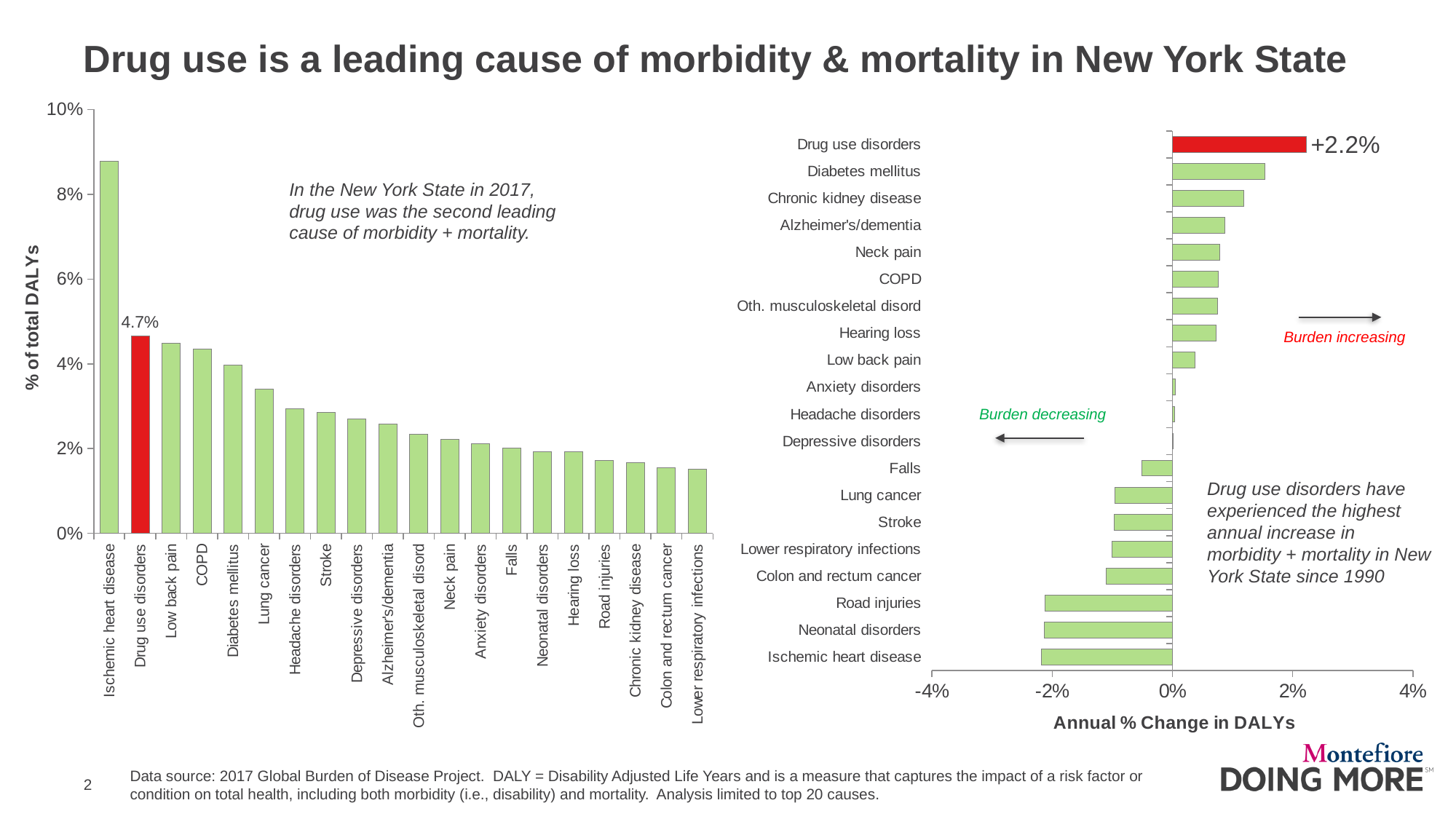
On the right chart (Annual % Change in DALYs), which is larger, the value for Diabetes mellitus or the value for Chronic kidney disease? Diabetes mellitus On the left chart (% of total DALYs), what is the value for Drug use disorders? 4.7% On the left chart (% of total DALYs), what colour is the bar for Drug use disorders? red On the left chart (% of total DALYs), is the value for Ischemic heart disease greater or less than 8%? greater On the left chart (% of total DALYs), is the value for Lung cancer greater or less than 2%? greater On the right chart (Annual % Change in DALYs), is the value for Lung cancer greater or less than 0%? less On the left chart (% of total DALYs), how many causes are plotted? 20 On the right chart (Annual % Change in DALYs), which cause has the highest annual % change? Drug use disorders What kind of chart is the right chart (Annual % Change in DALYs)? bar chart On the left chart (% of total DALYs), which cause has the highest share of total DALYs? Ischemic heart disease On the right chart (Annual % Change in DALYs), what is the value for Drug use disorders? +2.2% On the left chart (% of total DALYs), do the values rise or fall moving from left to right along the x axis? fall